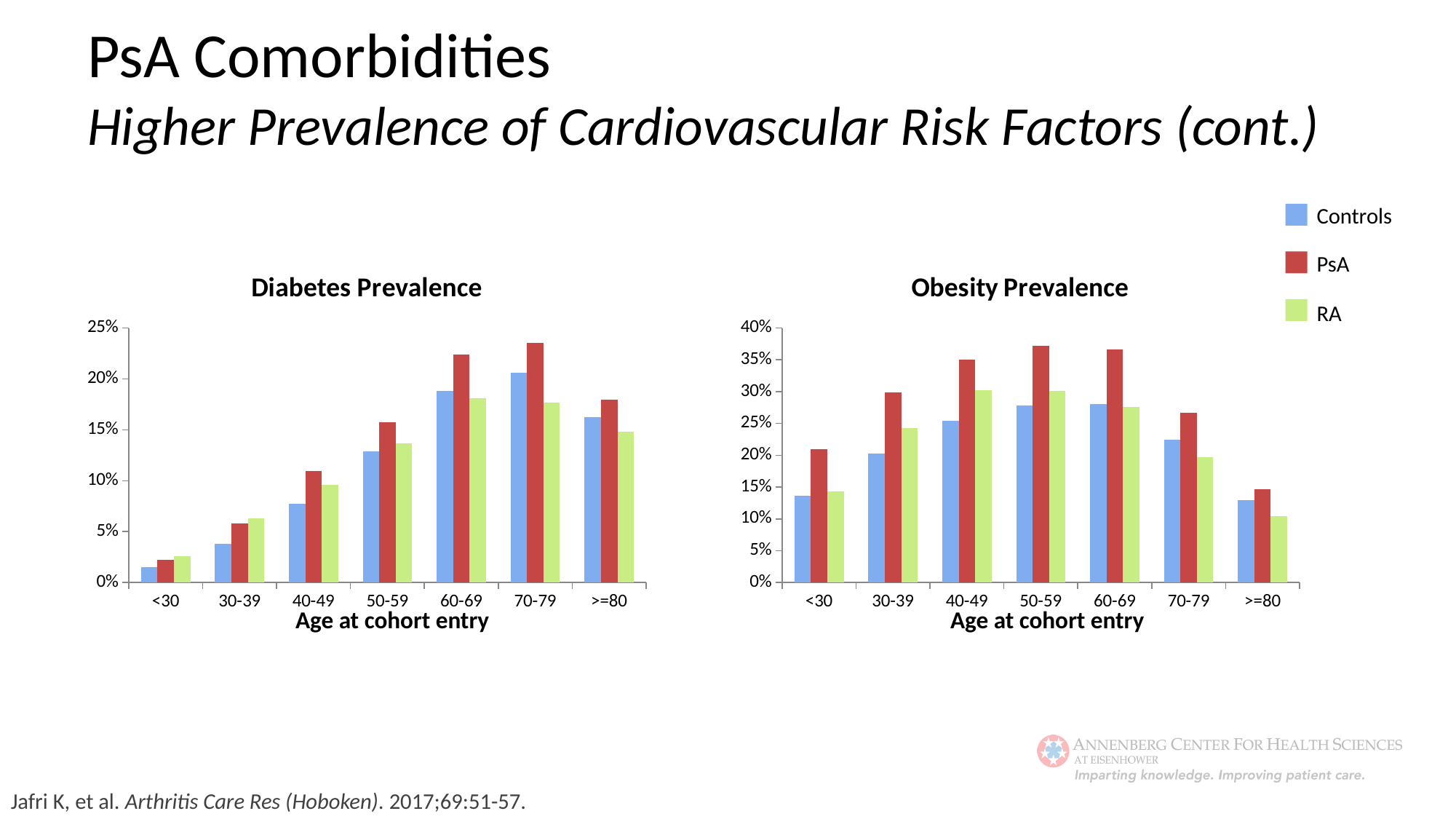
How many age groups are shown on the x axis of the Obesity Prevalence chart? 7 How many series does the legend list for the charts? 3 In the Diabetes Prevalence chart, which age group has the highest PsA value? 70-79 In the Obesity Prevalence chart, which age group has the lowest RA value? >=80 In the Obesity Prevalence chart, for the 40-49 age group, which is larger: PsA or Controls? PsA In the Obesity Prevalence chart, is the Controls value for <30 greater or less than 15%? less In the Diabetes Prevalence chart, is the PsA value for 60-69 greater or less than 20%? greater What is the x-axis title of the Obesity Prevalence chart? Age at cohort entry In the Diabetes Prevalence chart, which age group has the lowest Controls value? <30 In the Diabetes Prevalence chart, for the 30-39 age group, which is larger: RA or Controls? RA What kind of chart is the Diabetes Prevalence chart? Bar chart In the Diabetes Prevalence chart, do the Controls values rise or fall from <30 to 70-79? rise